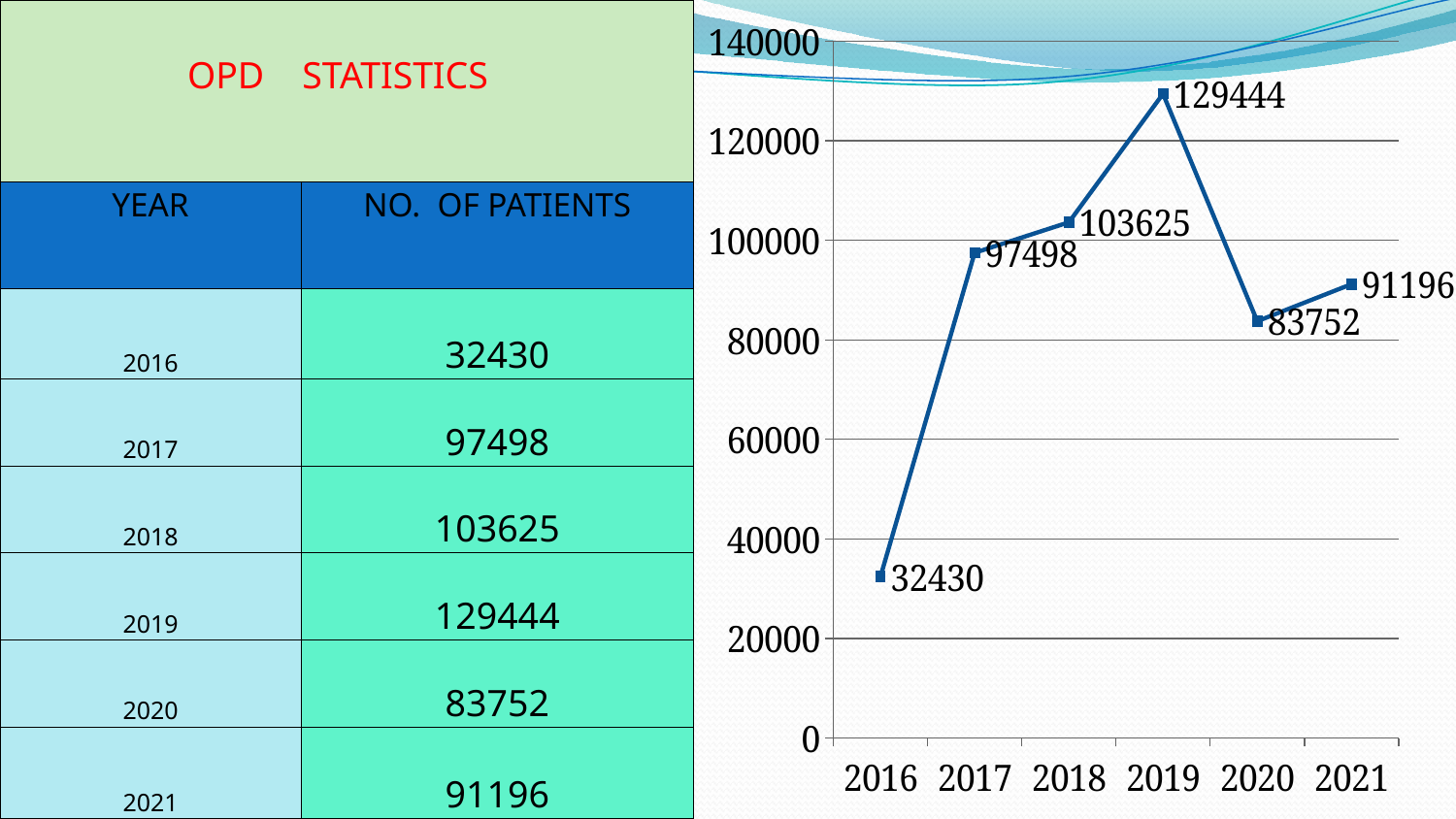
What is the number of patients plotted for 2021? 91196 What is the difference between the number of patients in 2019 and in 2020? 45692 What is the difference between the number of patients in 2018 and in 2017? 6127 What is the number of patients plotted for 2016? 32430 What is the number of patients plotted for 2019? 129444 How many years are plotted on the chart? 6 What kind of chart is shown on the slide? line chart Does the number of patients rise or fall from 2019 to 2020? fall Is the value for 2018 greater or less than 100000? greater Which year has the highest number of patients? 2019 Which year has more patients, 2020 or 2021? 2021 Which year has the lowest number of patients? 2016